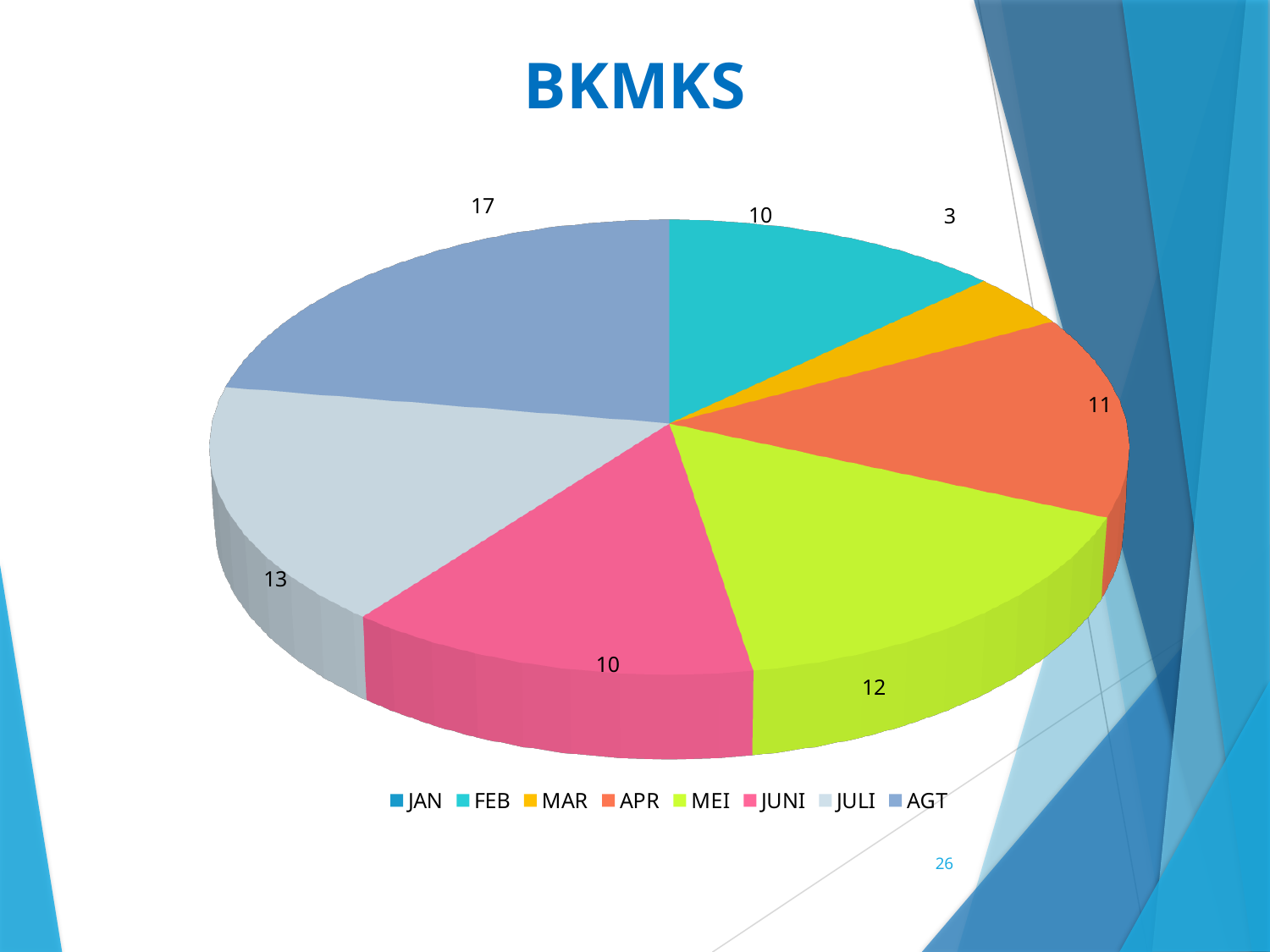
What is the value of the JULI slice? 13 Which month has the smallest labelled slice in the pie chart? MAR Which is larger, the JULI slice or the MEI slice? JULI What is the value of the MAR slice? 3 What kind of chart is shown on the slide? Pie chart Which month has the largest slice in the pie chart? AGT What is the value of the APR slice? 11 What is the title of the chart? BKMKS What is the value of the MEI slice? 12 What is the value of the AGT slice? 17 What is the difference between the AGT value and the MAR value? 14 How many entries does the legend list? 8